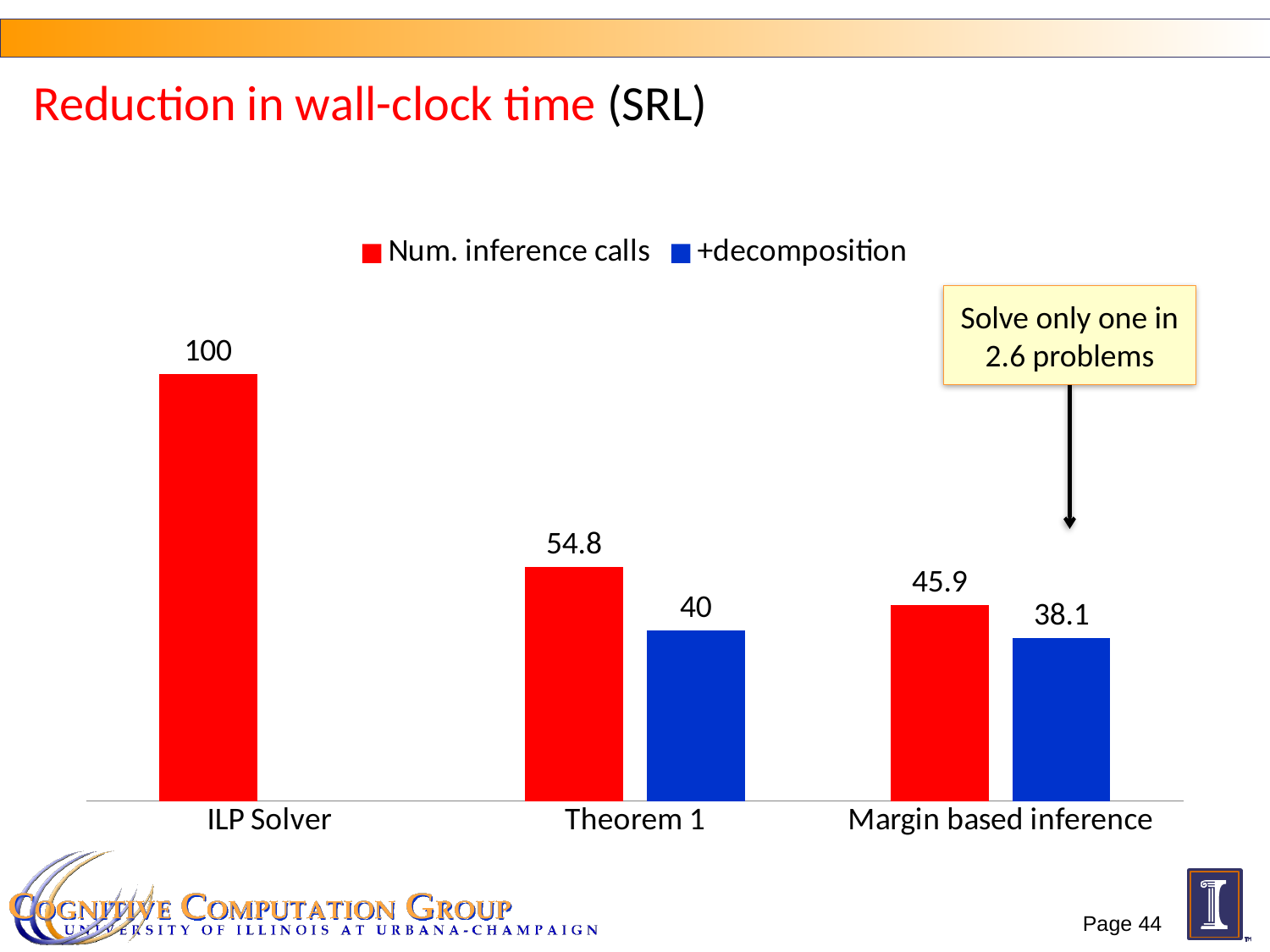
Which category has the lowest +decomposition value among those shown? Margin based inference How many series does the legend list? 2 Which is larger: +decomposition for Theorem 1 or +decomposition for Margin based inference? Theorem 1 What is the difference between the Num. inference calls values for Theorem 1 and Margin based inference? 8.9 What is the value of +decomposition for Margin based inference? 38.1 What is the value of Num. inference calls for Margin based inference? 45.9 What kind of chart is shown on the slide? Bar chart Which category has the highest Num. inference calls value? ILP Solver What is the value of Num. inference calls for Theorem 1? 54.8 What is the value of +decomposition for Theorem 1? 40 What is the value of Num. inference calls for ILP Solver? 100 What is the difference between Num. inference calls and +decomposition for Theorem 1? 14.8